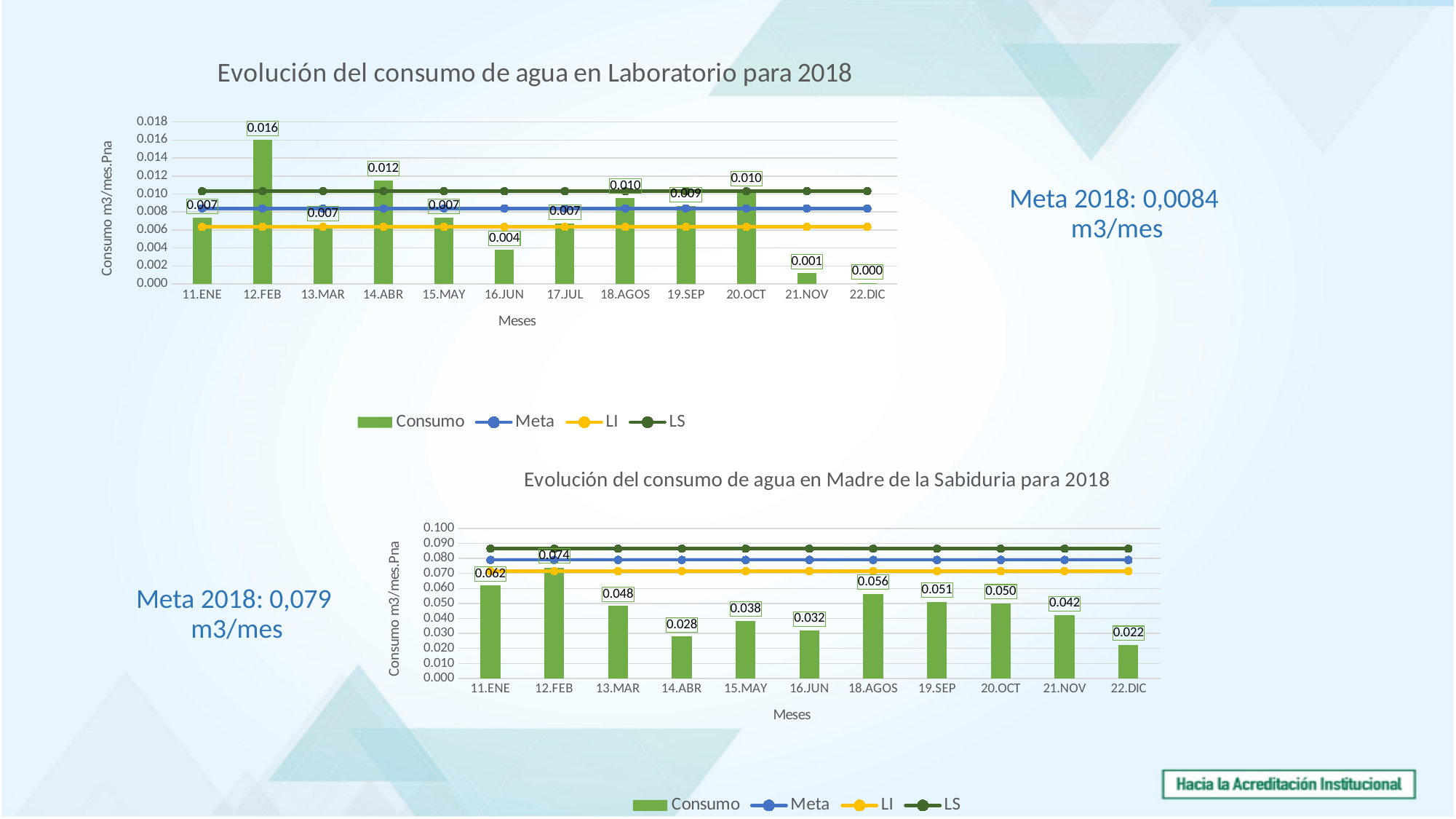
In the chart 'Evolución del consumo de agua en Madre de la Sabiduria para 2018', what is the difference between the Consumo values for 12.FEB and 14.ABR? 0.046 In the chart 'Evolución del consumo de agua en Laboratorio para 2018', which month has the lowest Consumo value? 22.DIC In the chart 'Evolución del consumo de agua en Laboratorio para 2018', which month has the highest Consumo value? 12.FEB In the chart 'Evolución del consumo de agua en Laboratorio para 2018', what is the Consumo value for 12.FEB? 0.016 In the chart 'Evolución del consumo de agua en Laboratorio para 2018', what is the difference between the Consumo values for 14.ABR and 16.JUN? 0.008 In the chart 'Evolución del consumo de agua en Madre de la Sabiduria para 2018', is the Consumo value for 11.ENE or 13.MAR larger? 11.ENE In the chart 'Evolución del consumo de agua en Madre de la Sabiduria para 2018', which month has the highest Consumo value? 12.FEB In the chart 'Evolución del consumo de agua en Laboratorio para 2018', how many months are shown on the x axis? 12 In the chart 'Evolución del consumo de agua en Madre de la Sabiduria para 2018', what is the Consumo value for 18.AGOS? 0.056 In the chart 'Evolución del consumo de agua en Laboratorio para 2018', how many series does the legend list? 4 In the chart 'Evolución del consumo de agua en Madre de la Sabiduria para 2018', which month has the lowest Consumo value? 22.DIC In the chart 'Evolución del consumo de agua en Madre de la Sabiduria para 2018', how many months are shown on the x axis? 11